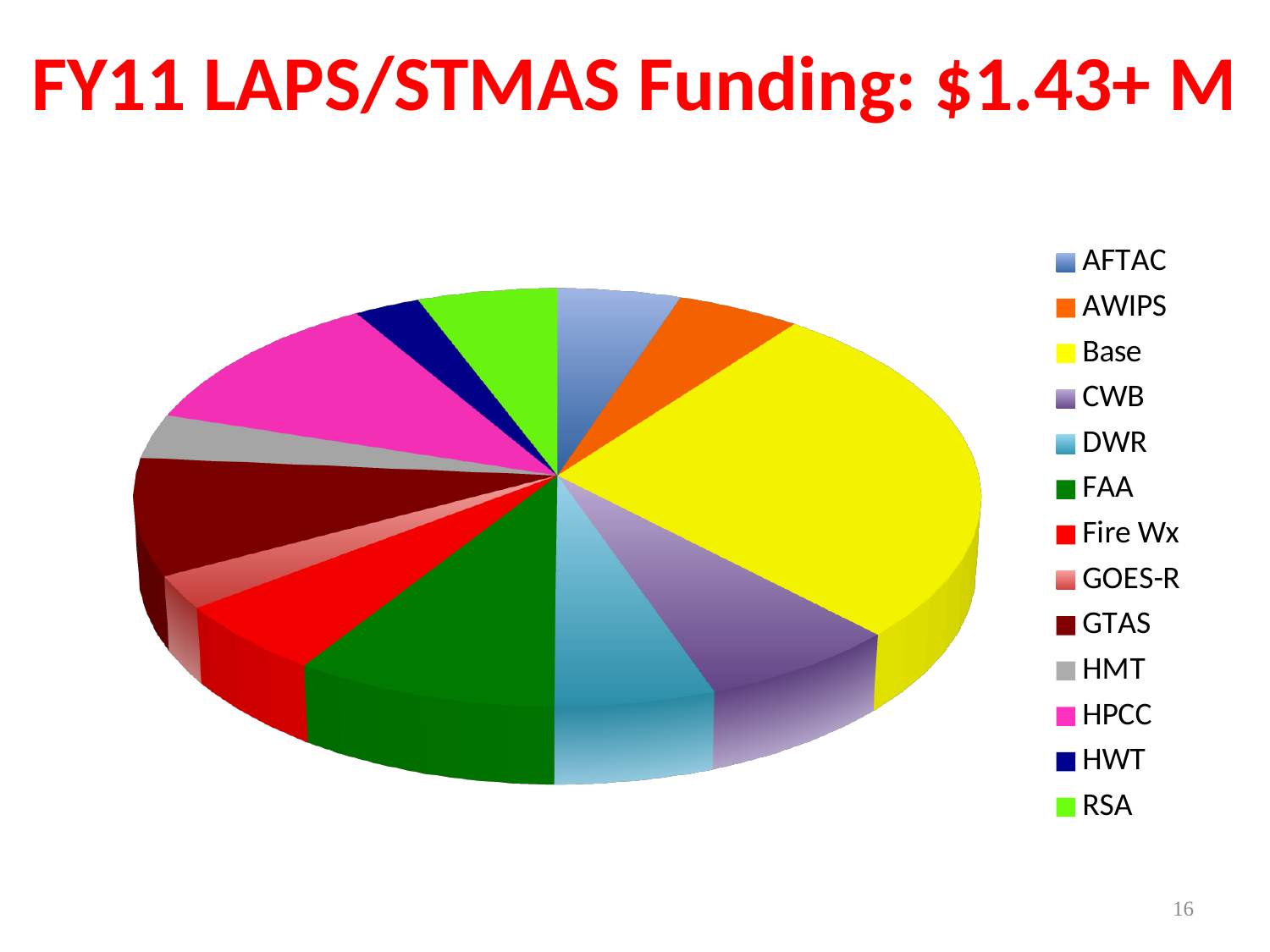
How many categories (slices) does the pie chart have? 13 Which slice is larger, GTAS or HMT? GTAS What colour is the Base slice in the pie chart? yellow Which category has the largest slice of the pie chart? Base Which slice is larger, DWR or HWT? DWR Which slice is larger, HPCC or HWT? HPCC What is the title of the slide containing the pie chart? FY11 LAPS/STMAS Funding: $1.43+ M What kind of chart is shown on the slide? pie chart